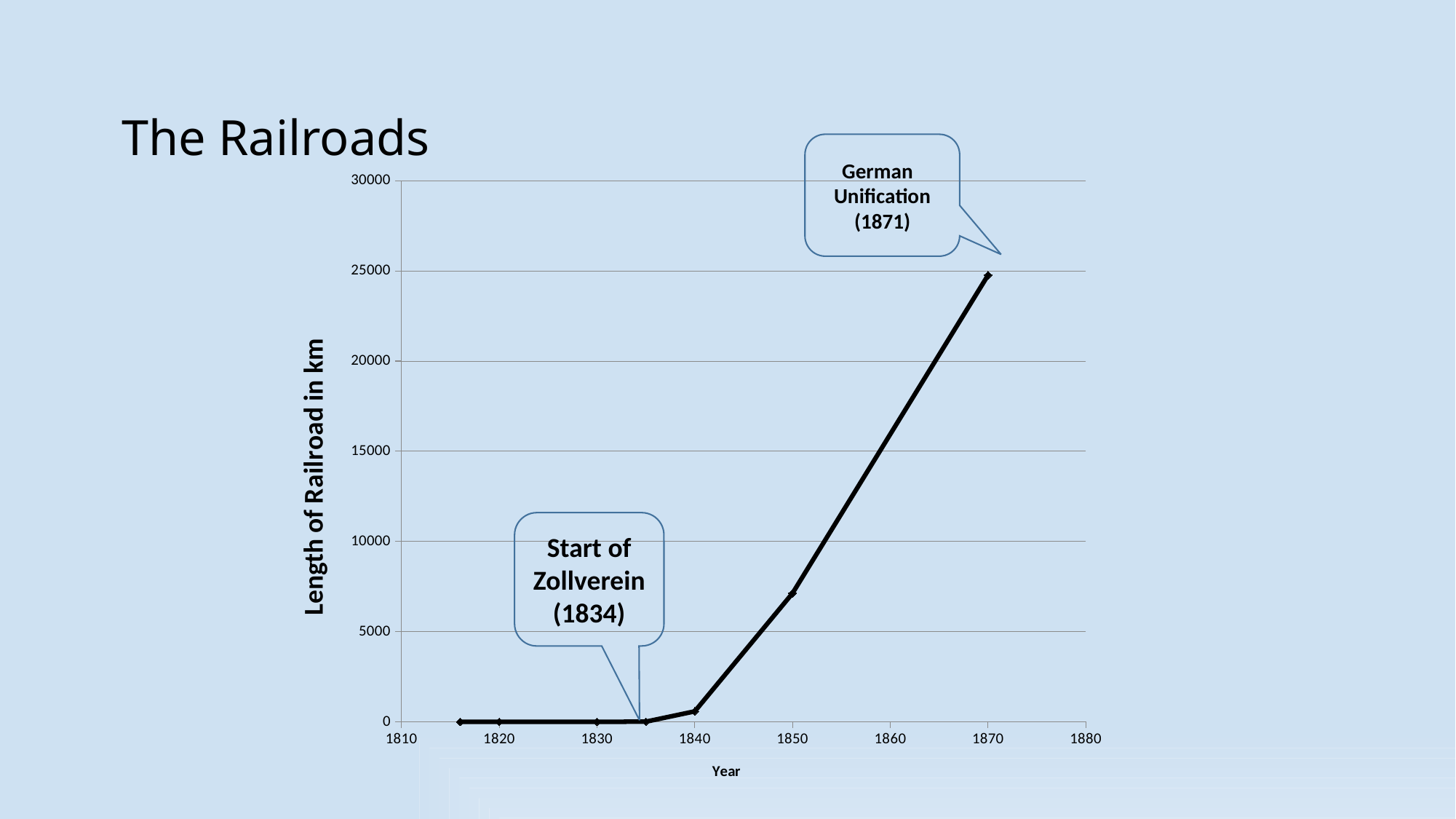
Is the value for 1850 greater or less than 10000? less Do the values rise or fall along the x axis from 1840 to 1870? rise Which is larger, the value for 1850 or the value for 1870? 1870 Is the value for 1870 greater or less than 20000? greater Which is larger, the value for 1840 or the value for 1850? 1850 Which year has the highest length of railroad? 1870 What kind of chart is shown on the slide? line chart What is the title of the x axis? Year Is the value for 1850 greater or less than 5000? greater What is the title of the y axis? Length of Railroad in km